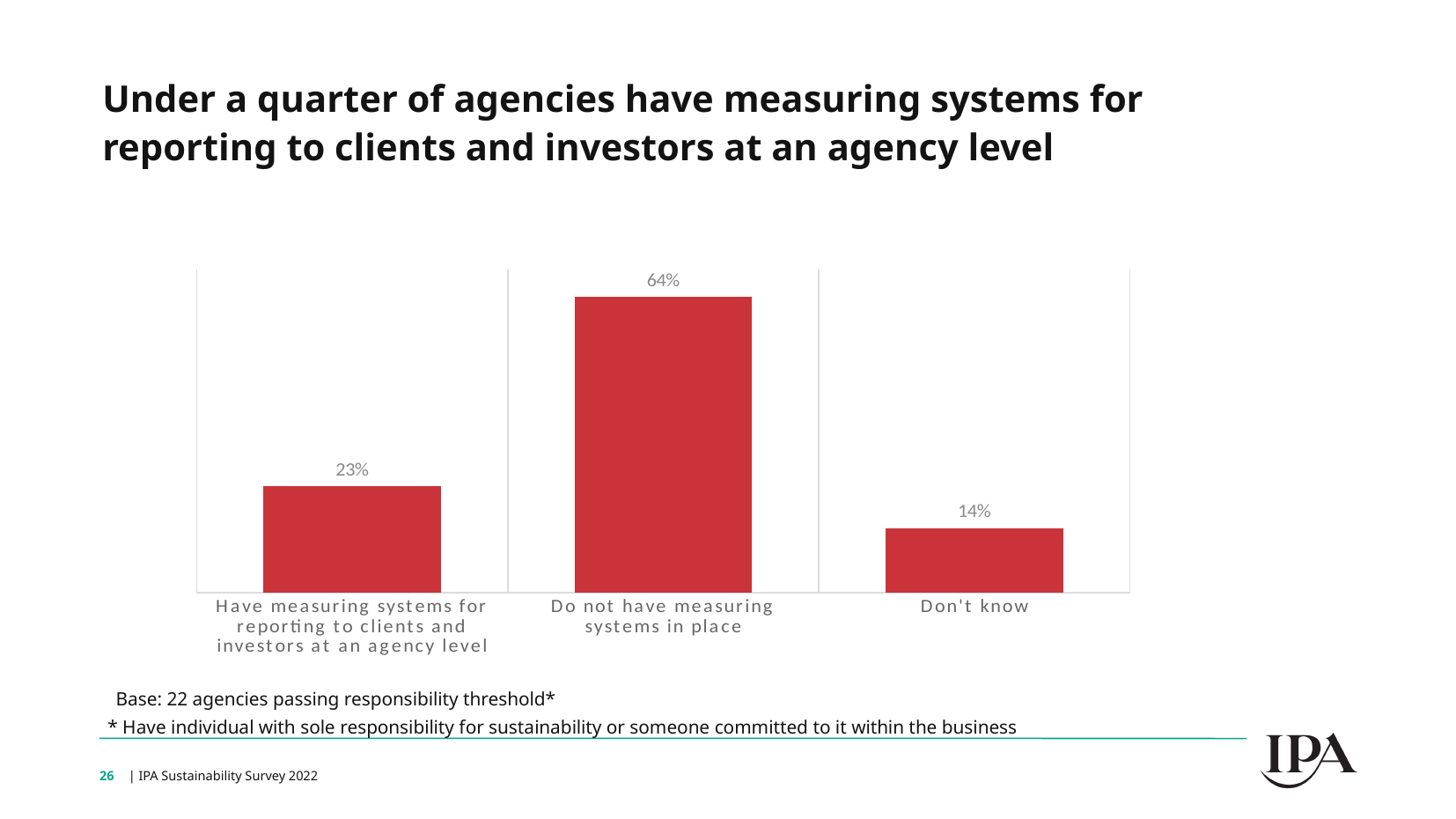
What colour are the bars in the chart? Red What percentage of agencies do not have measuring systems in place? 64% How many categories are shown in the chart? 3 What is the base size stated below the chart? 22 agencies passing responsibility threshold What is the difference between the 'Have measuring systems for reporting to clients and investors at an agency level' value and the 'Don't know' value? 9% Which is larger: the value for 'Have measuring systems for reporting to clients and investors at an agency level' or the value for 'Don't know'? Have measuring systems for reporting to clients and investors at an agency level Which category has the lowest value? Don't know What kind of chart is shown on the slide? Bar chart What is the difference between the 'Do not have measuring systems in place' value and the 'Have measuring systems for reporting to clients and investors at an agency level' value? 41% Which category has the highest value? Do not have measuring systems in place What percentage of agencies answered 'Don't know'? 14% What percentage of agencies have measuring systems for reporting to clients and investors at an agency level? 23%